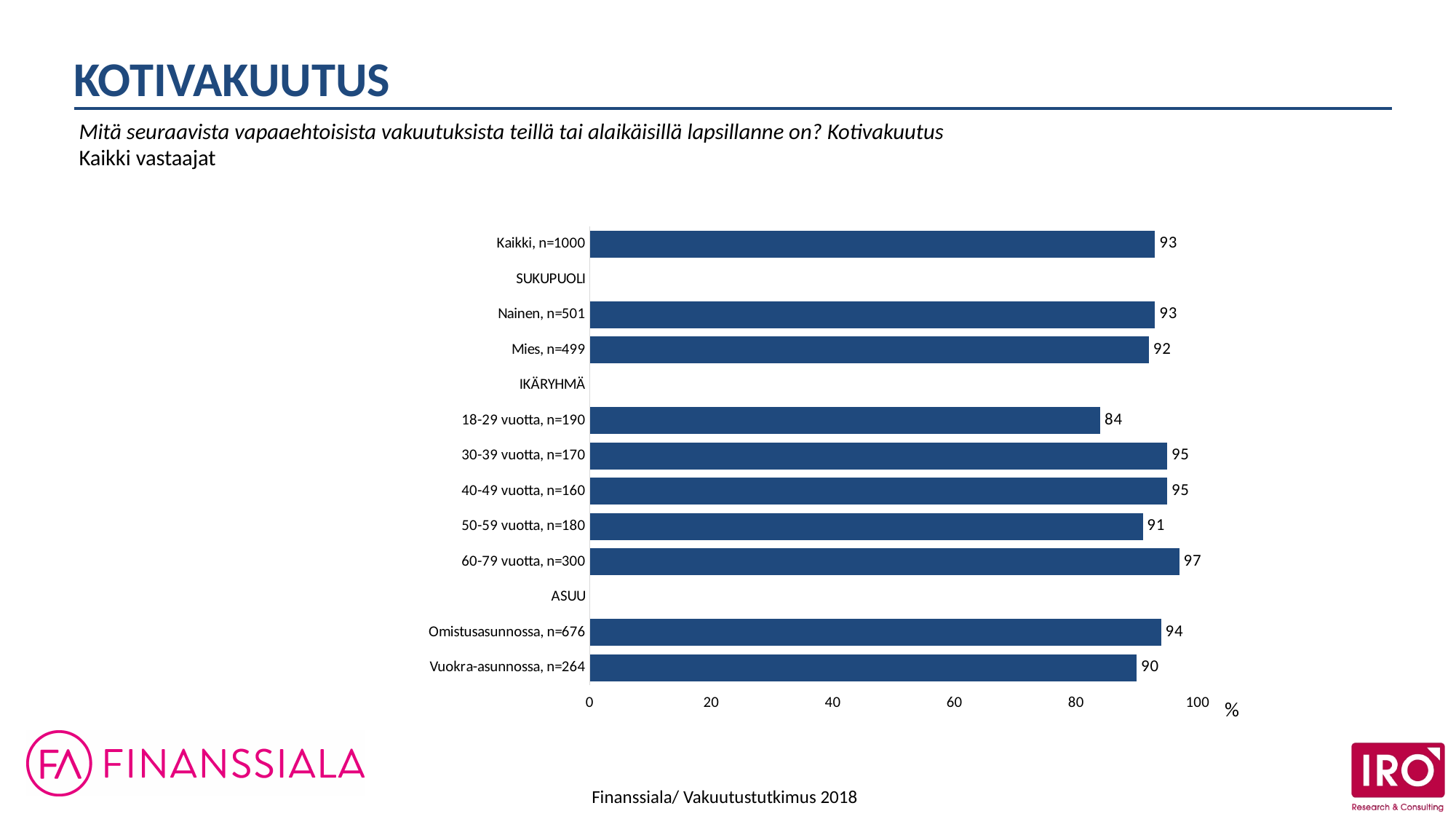
How many bars are plotted in the chart? 10 What is the title of the slide? KOTIVAKUUTUS What kind of chart is shown on the slide? bar chart What is the value for Mies, n=499? 92 What is the difference between the values for 60-79 vuotta, n=300 and 18-29 vuotta, n=190? 13 Which category has the lowest value? 18-29 vuotta, n=190 What is the value for 18-29 vuotta, n=190? 84 Is the value for 50-59 vuotta, n=180 greater or less than 80? greater Which is larger, the value for Omistusasunnossa, n=676 or Vuokra-asunnossa, n=264? Omistusasunnossa, n=676 Which category has the highest value? 60-79 vuotta, n=300 What is the value for Kaikki, n=1000? 93 What is the value for Vuokra-asunnossa, n=264? 90